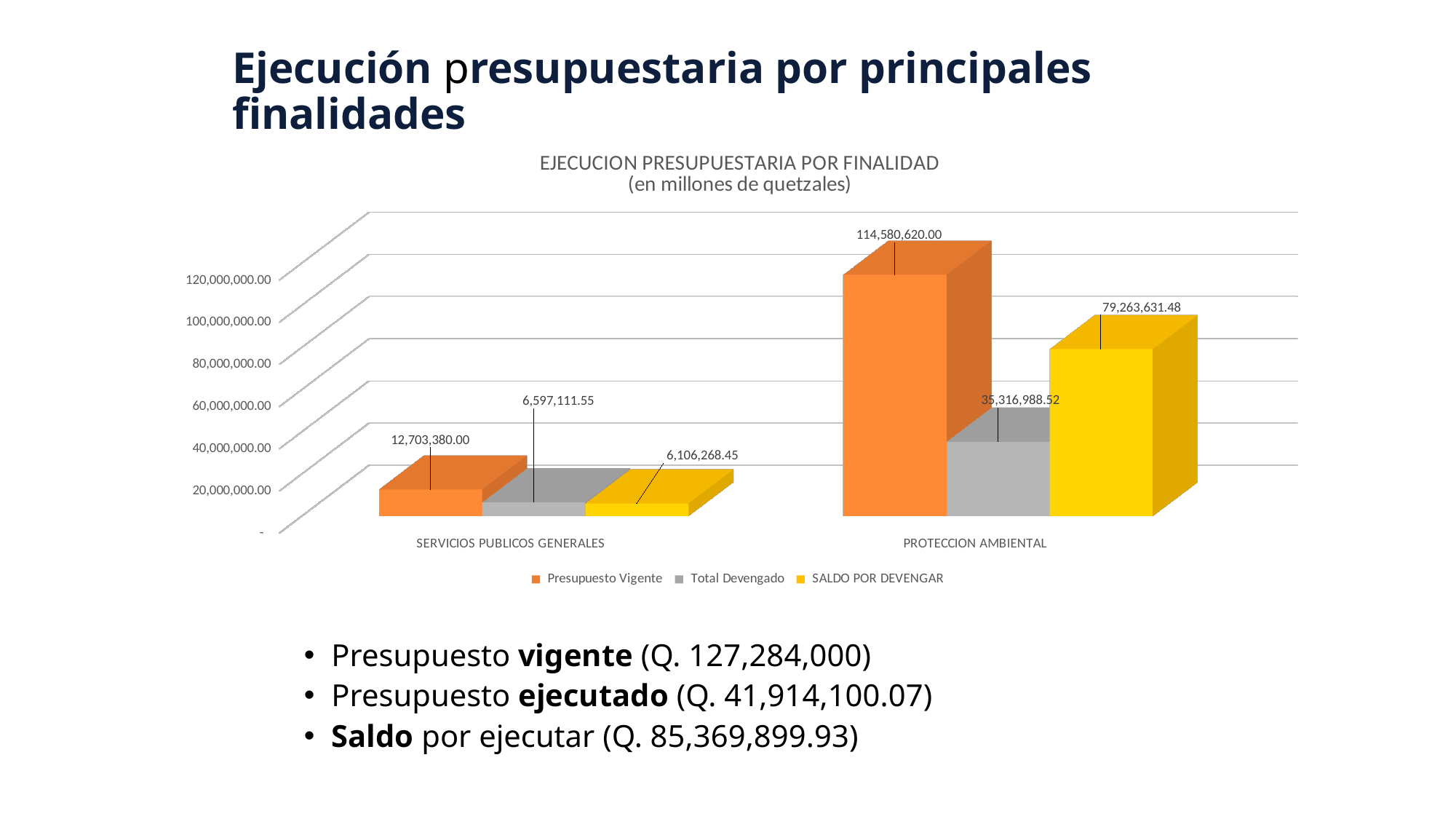
What is the difference between the Presupuesto Vigente values for PROTECCION AMBIENTAL and SERVICIOS PUBLICOS GENERALES? 101,877,240.00 How many categories are shown on the x axis of the chart? 2 What type of chart is shown on the slide? Bar chart What is the Total Devengado value for SERVICIOS PUBLICOS GENERALES? 6,597,111.55 Which is larger for PROTECCION AMBIENTAL: Total Devengado or SALDO POR DEVENGAR? SALDO POR DEVENGAR What is the Presupuesto Vigente value for SERVICIOS PUBLICOS GENERALES? 12,703,380.00 Which series has the lowest value for SERVICIOS PUBLICOS GENERALES? SALDO POR DEVENGAR Which category has the highest Presupuesto Vigente? PROTECCION AMBIENTAL What is the Presupuesto Vigente value for PROTECCION AMBIENTAL? 114,580,620.00 What is the SALDO POR DEVENGAR value for PROTECCION AMBIENTAL? 79,263,631.48 How many series does the chart legend list? 3 What is the difference between Presupuesto Vigente and SALDO POR DEVENGAR for PROTECCION AMBIENTAL? 35,316,988.52